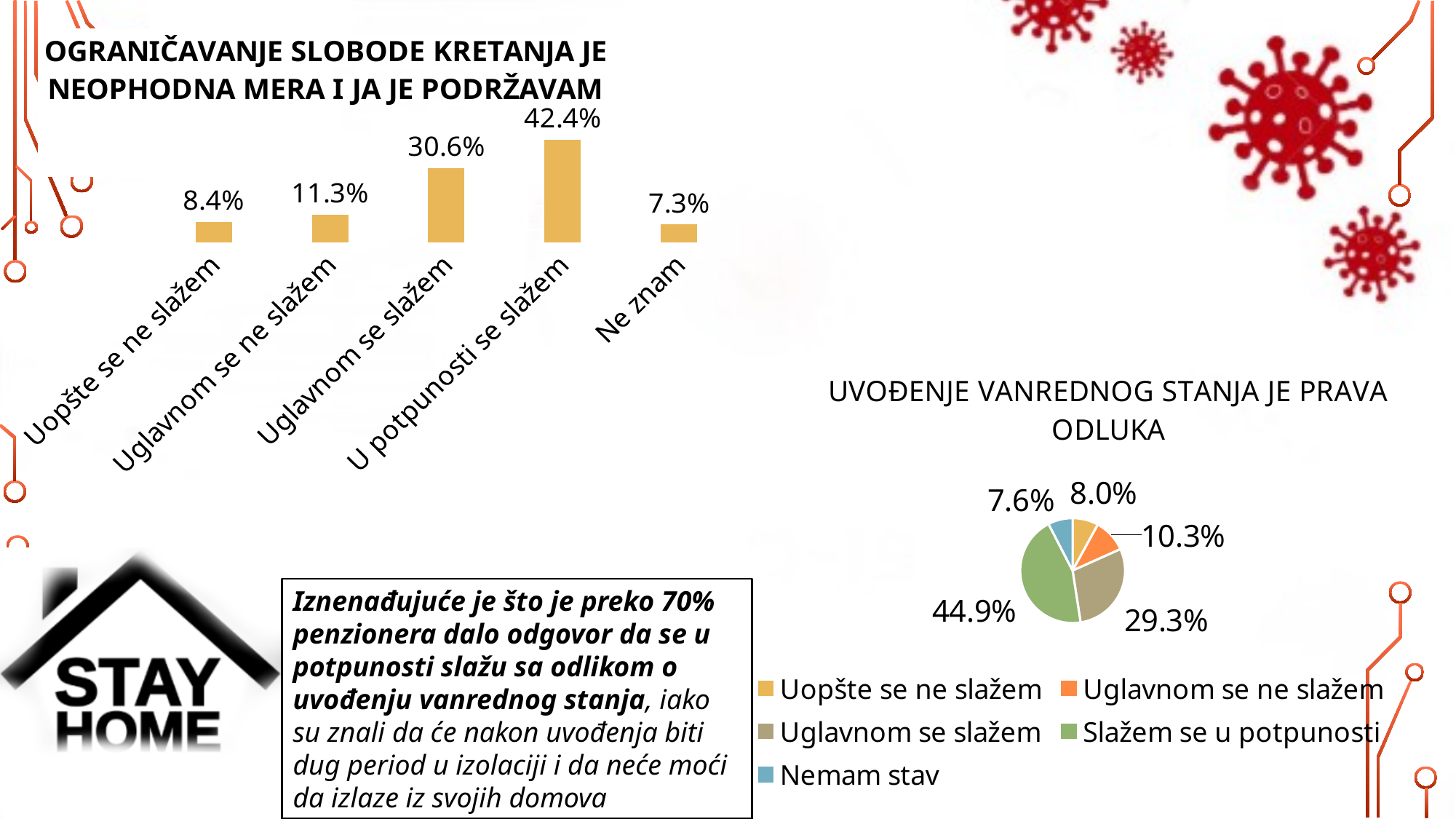
In the bar chart titled "OGRANIČAVANJE SLOBODE KRETANJA JE NEOPHODNA MERA I JA JE PODRŽAVAM", which category has the lowest value? Ne znam In the bar chart titled "OGRANIČAVANJE SLOBODE KRETANJA JE NEOPHODNA MERA I JA JE PODRŽAVAM", which category has the highest value? U potpunosti se slažem In the bar chart titled "OGRANIČAVANJE SLOBODE KRETANJA JE NEOPHODNA MERA I JA JE PODRŽAVAM", what is the value for "Uglavnom se ne slažem"? 11.3% In the pie chart titled "UVOĐENJE VANREDNOG STANJA JE PRAVA ODLUKA", which is larger: "Uglavnom se ne slažem" or "Uopšte se ne slažem"? Uglavnom se ne slažem In the bar chart titled "OGRANIČAVANJE SLOBODE KRETANJA JE NEOPHODNA MERA I JA JE PODRŽAVAM", how many categories are shown? 5 In the pie chart titled "UVOĐENJE VANREDNOG STANJA JE PRAVA ODLUKA", what colour is the "Slažem se u potpunosti" slice? Green In the pie chart titled "UVOĐENJE VANREDNOG STANJA JE PRAVA ODLUKA", what is the value for "Nemam stav"? 7.6% In the pie chart titled "UVOĐENJE VANREDNOG STANJA JE PRAVA ODLUKA", what is the share for "Slažem se u potpunosti"? 44.9% In the bar chart titled "OGRANIČAVANJE SLOBODE KRETANJA JE NEOPHODNA MERA I JA JE PODRŽAVAM", what is the difference between "U potpunosti se slažem" and "Uglavnom se slažem"? 11.8% In the bar chart titled "OGRANIČAVANJE SLOBODE KRETANJA JE NEOPHODNA MERA I JA JE PODRŽAVAM", what is the value for "U potpunosti se slažem"? 42.4% What type of chart is the chart titled "OGRANIČAVANJE SLOBODE KRETANJA JE NEOPHODNA MERA I JA JE PODRŽAVAM"? Bar chart How many entries does the legend of the pie chart titled "UVOĐENJE VANREDNOG STANJA JE PRAVA ODLUKA" list? 5